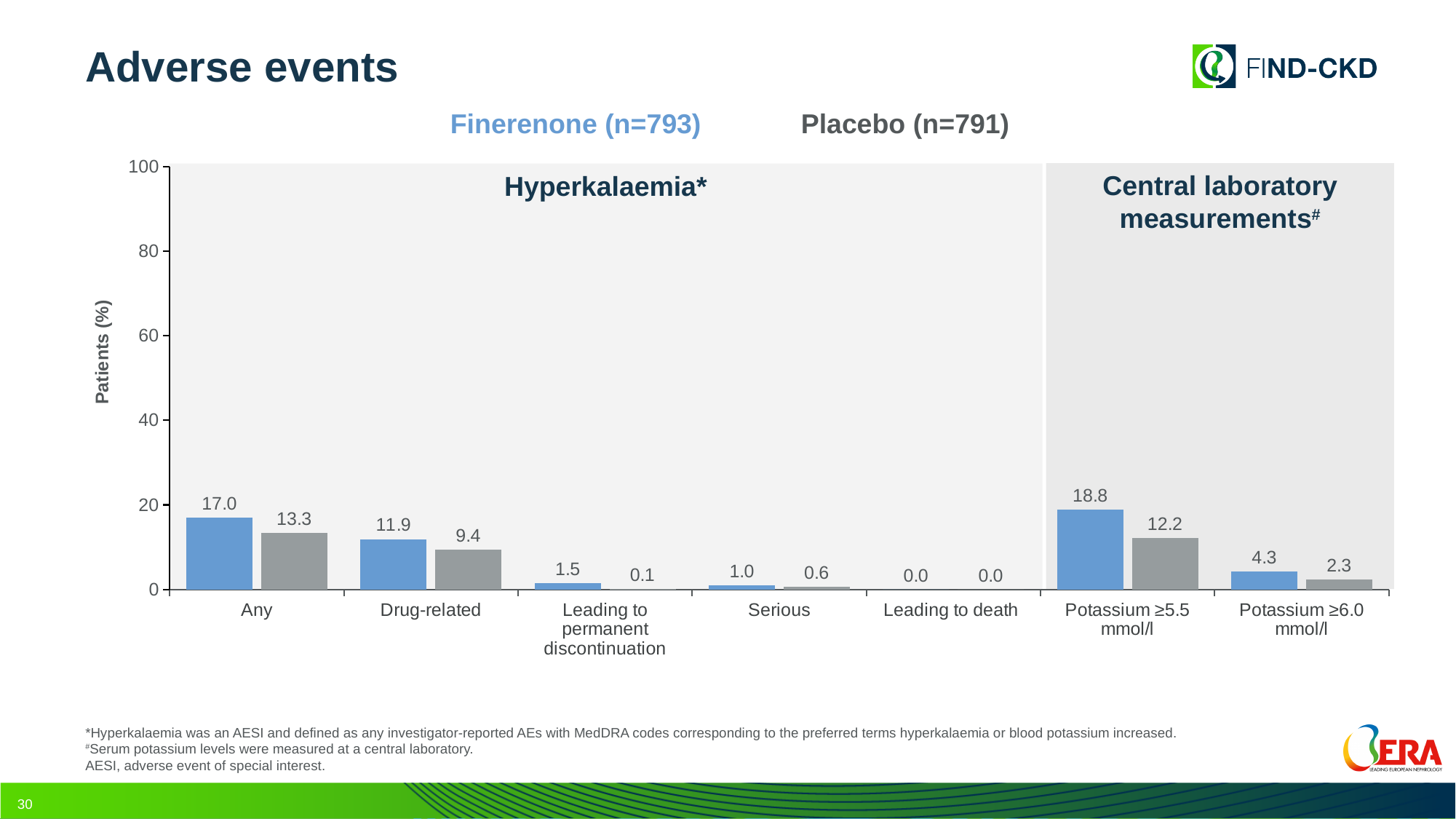
What is the Finerenone value for 'Potassium ≥5.5 mmol/l'? 18.8 How many series does the chart show? 2 What is the difference between the Finerenone and Placebo values for 'Potassium ≥6.0 mmol/l'? 2.0 Which is larger for 'Serious' adverse events: Finerenone or Placebo? Finerenone What kind of chart is shown on the slide? Bar chart Which category has the lowest Placebo value? Leading to death Which category has the highest Finerenone value? Potassium ≥5.5 mmol/l What is the Finerenone value for the 'Any' category? 17.0 What is the difference between the Finerenone and Placebo values for 'Any'? 3.7 What is the Placebo value for 'Drug-related' adverse events? 9.4 What is the Placebo value for 'Leading to permanent discontinuation'? 0.1 How many categories are shown on the x axis? 7